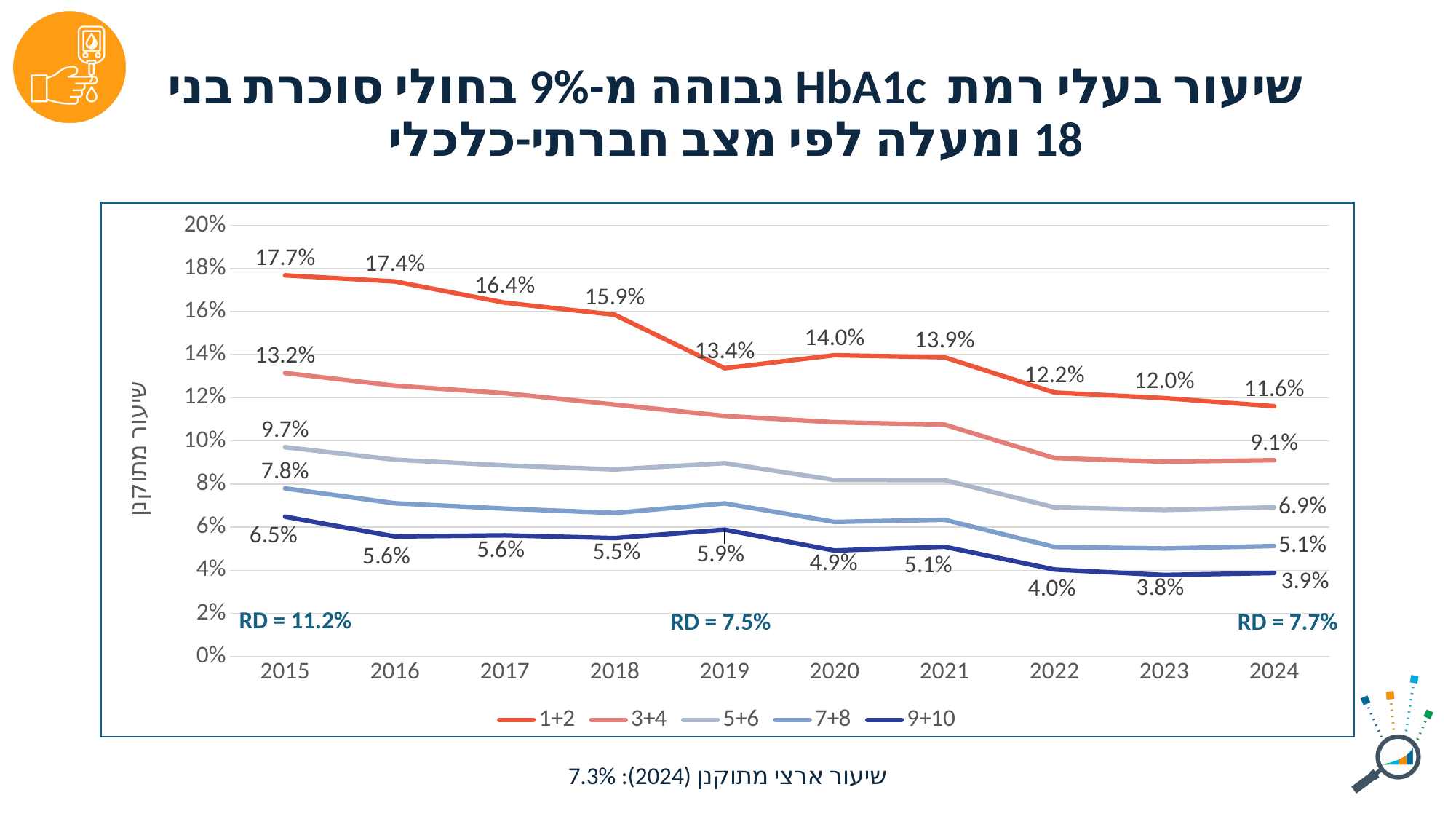
In which year is the 9+10 series at its highest value? 2015 Which series has the larger value in 2024, 5+6 or 7+8? 5+6 How many series does the legend list? 5 Does the 1+2 series generally rise or fall from 2015 to 2024? fall What is the difference between the 1+2 series and the 9+10 series in 2015? 11.2% Is the value for the 3+4 series in 2019 greater or less than 12%? less What is the value for the 9+10 series in 2024? 3.9% In which year is the 1+2 series at its lowest value? 2024 What is the value for the 3+4 series in 2024? 9.1% What type of chart is shown on the slide? line chart What is the value for the 1+2 series in 2015? 17.7% How many years are shown on the x axis? 10